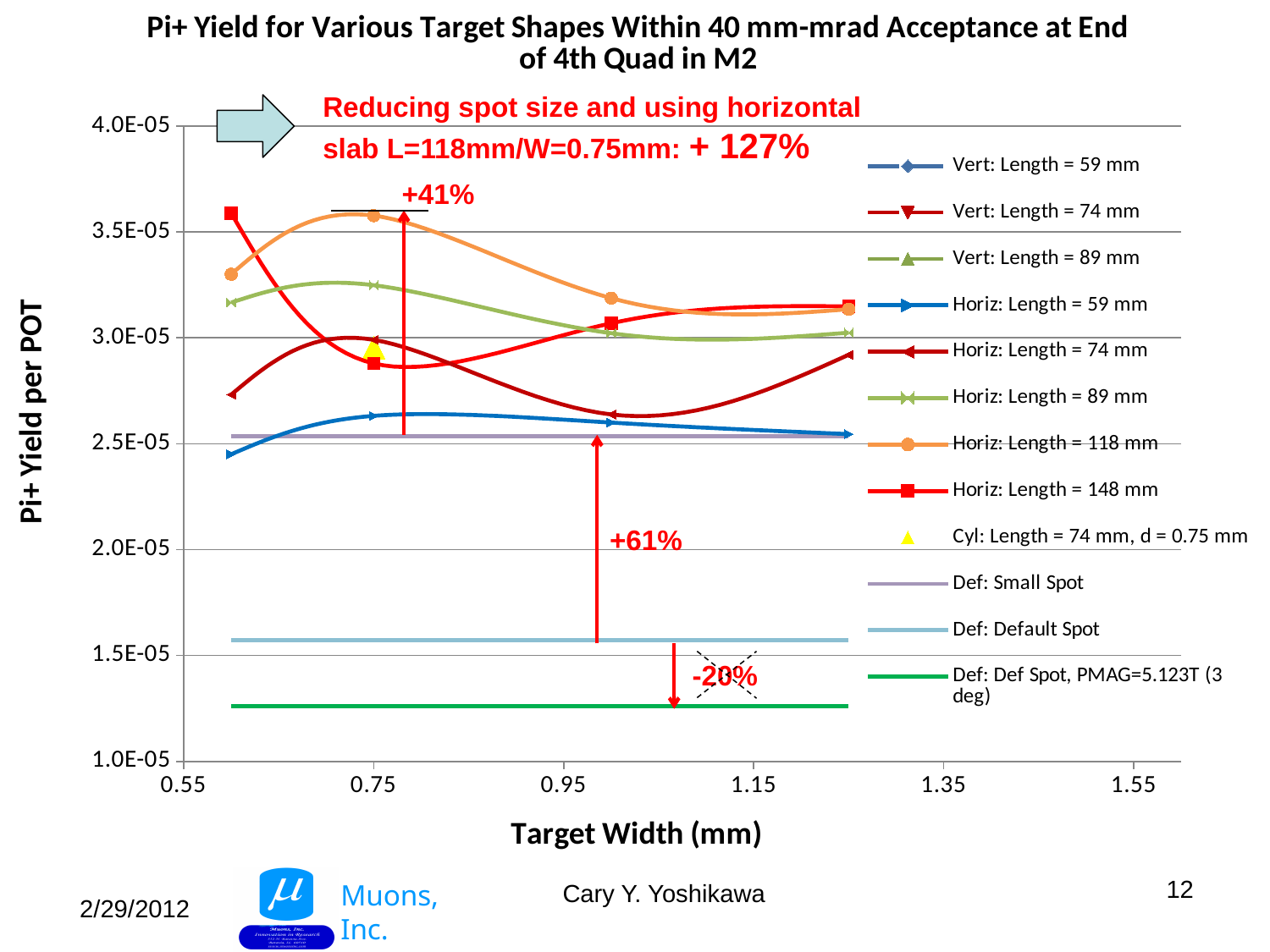
Does the Horiz: Length = 118 mm series rise or fall as target width increases from 0.75 mm to 1.2 mm? fall Which line is lower, Def: Default Spot or Def: Def Spot, PMAG=5.123T (3 deg)? Def: Def Spot, PMAG=5.123T (3 deg) At a target width of 1.0 mm, which series has the highest Pi+ yield per POT? Horiz: Length = 118 mm What is the title of the y axis? Pi+ Yield per POT Is the value of the Def: Def Spot, PMAG=5.123T (3 deg) line greater or less than 1.5E-05? less Is the value of the Def: Default Spot line greater or less than 1.5E-05? greater Is the value for Horiz: Length = 74 mm at a target width of 0.6 mm greater or less than 2.5E-05? greater What is the title of the x axis? Target Width (mm) How many series does the legend list? 12 What kind of chart is shown on the slide? line chart